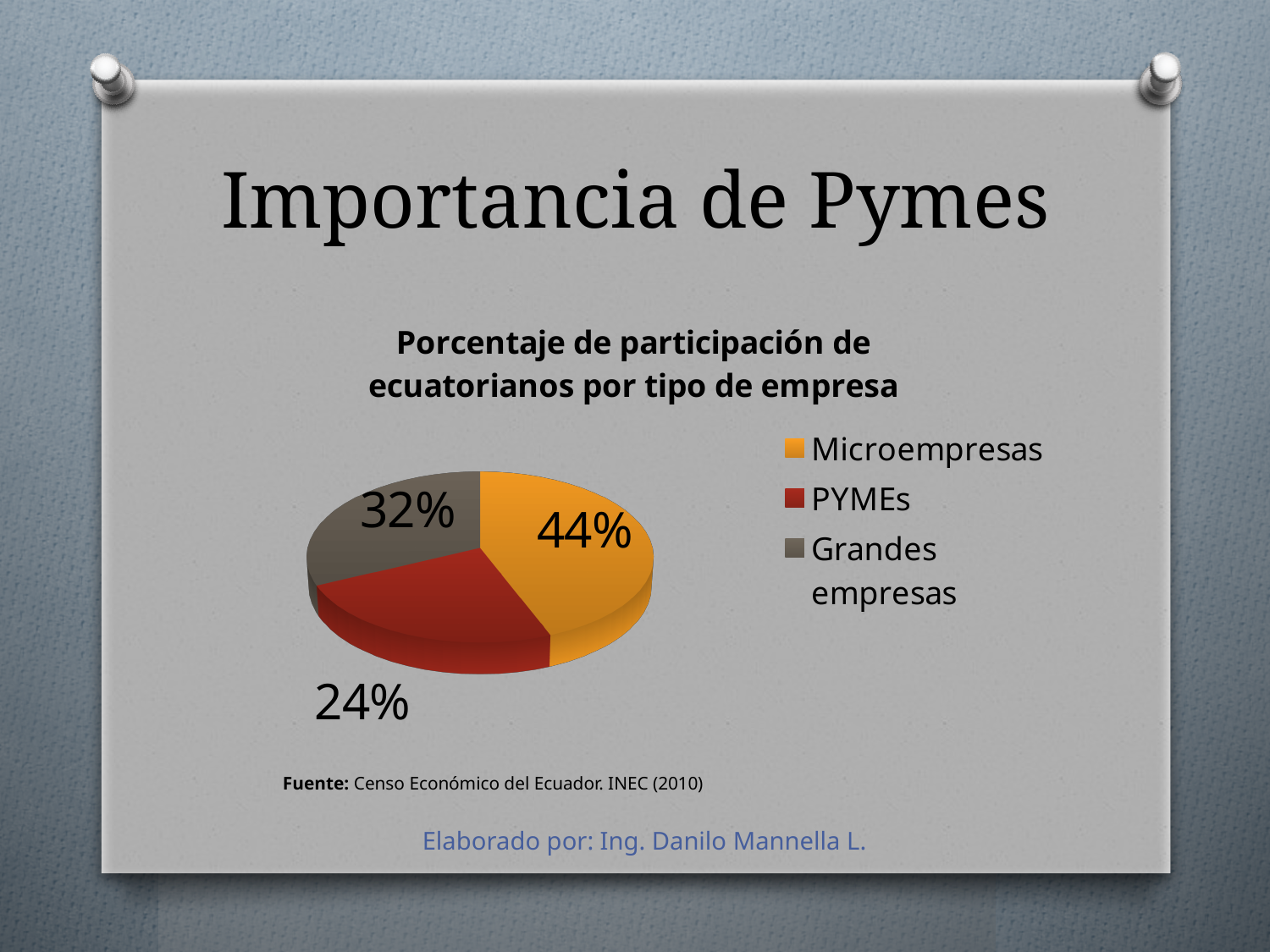
Which category has the largest share of the pie? Microempresas What percentage of the pie corresponds to PYMEs? 24% What percentage of the pie corresponds to Grandes empresas? 32% Which is larger, the share for Microempresas or the share for PYMEs? Microempresas Which category has the smallest share of the pie? PYMEs What colour represents Microempresas in the pie chart? orange What type of chart is shown on the slide? pie chart How many slices does the pie chart have? 3 What percentage of the pie corresponds to Microempresas? 44% What is the difference in percentage points between Microempresas and Grandes empresas? 12 What is the title of the chart? Porcentaje de participación de ecuatorianos por tipo de empresa How many categories does the legend of the pie chart list? 3